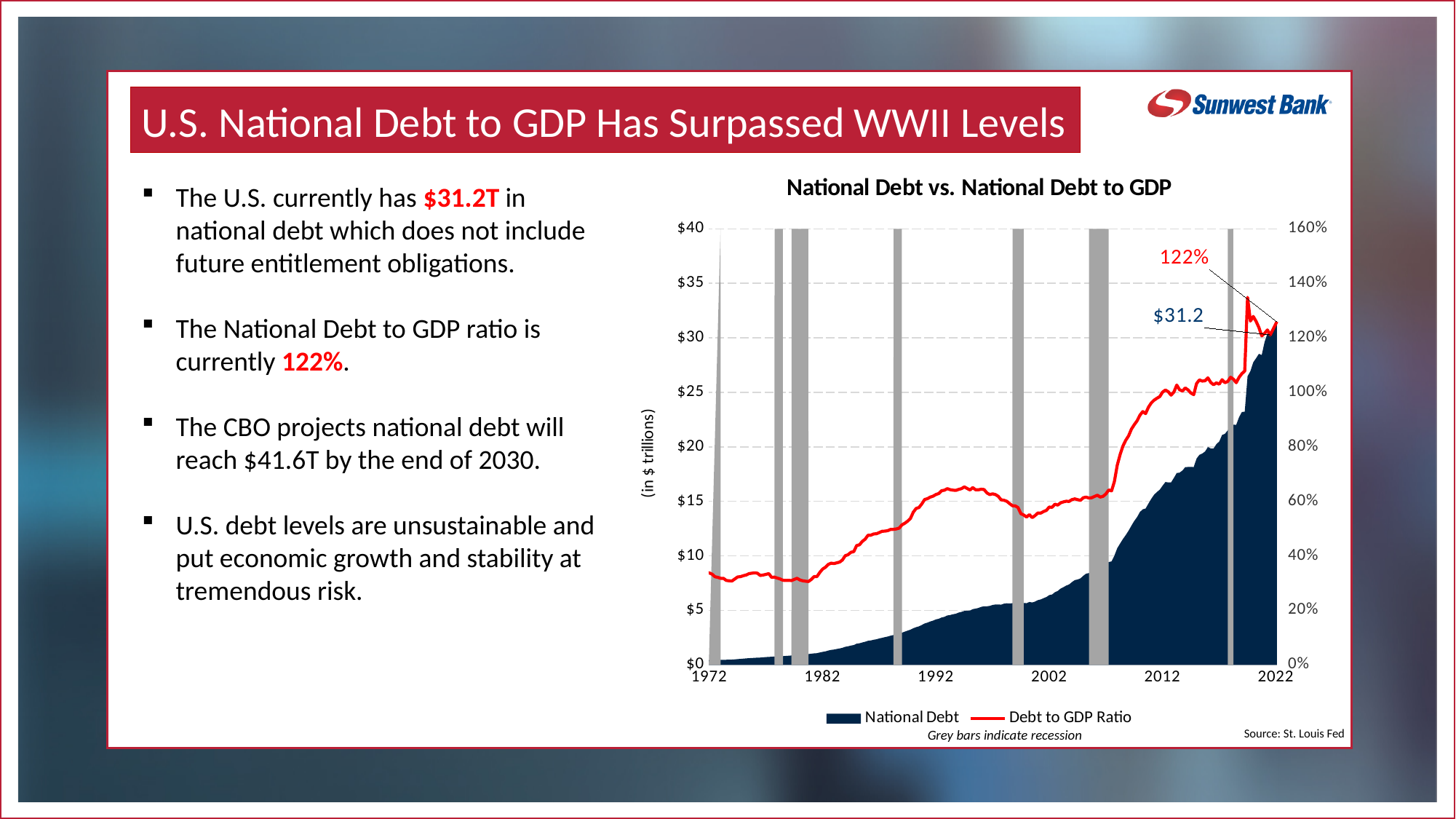
What is the most recent National Debt value labelled on the chart? $31.2 What kind of chart is shown on the slide? Area and line chart In which year shown on the x axis is the National Debt highest? 2022 Is the National Debt in 2002 greater or less than $10 trillion? less Does the National Debt rise or fall from 1972 to 2022? Rise Was the Debt to GDP Ratio larger in 1972 or in 1992? 1992 How many series does the chart legend list? 2 Is the Debt to GDP Ratio in 2012 greater or less than 80%? greater What is the title of the chart? National Debt vs. National Debt to GDP Is the Debt to GDP Ratio in 1982 greater or less than 40%? less What is the most recent Debt to GDP Ratio value labelled on the chart? 122%